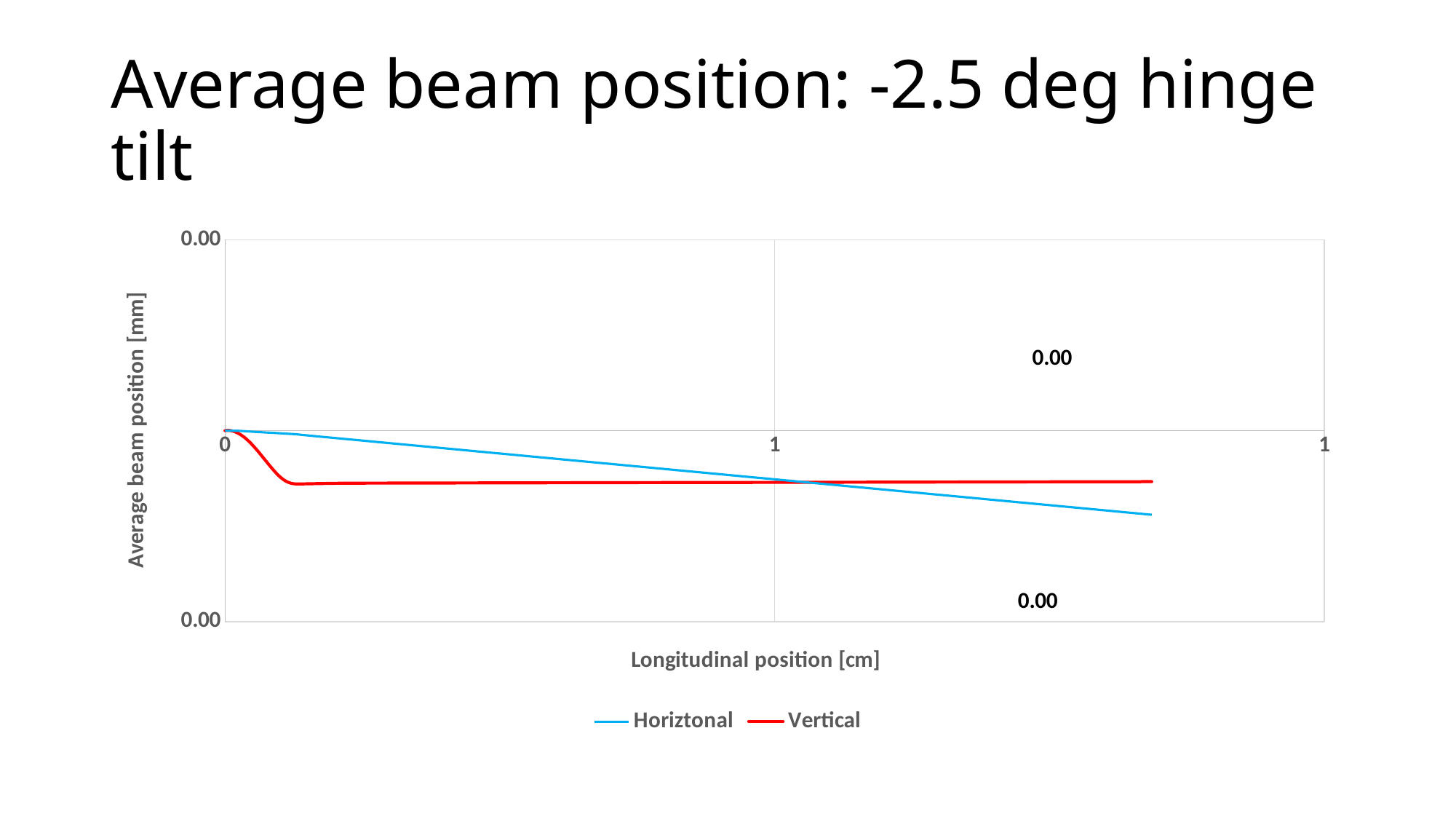
What kind of chart is shown on the slide? line chart How many series does the legend list? 2 What are the two series named in the legend? Horiztonal and Vertical What is the title of the chart's x axis? Longitudinal position [cm] At the right-hand end of the plotted lines, which series has the higher average beam position, Horiztonal or Vertical? Vertical Which series shows a sharp drop near the start of the x axis, Horiztonal or Vertical? Vertical Does the Horiztonal series rise or fall as longitudinal position increases? fall